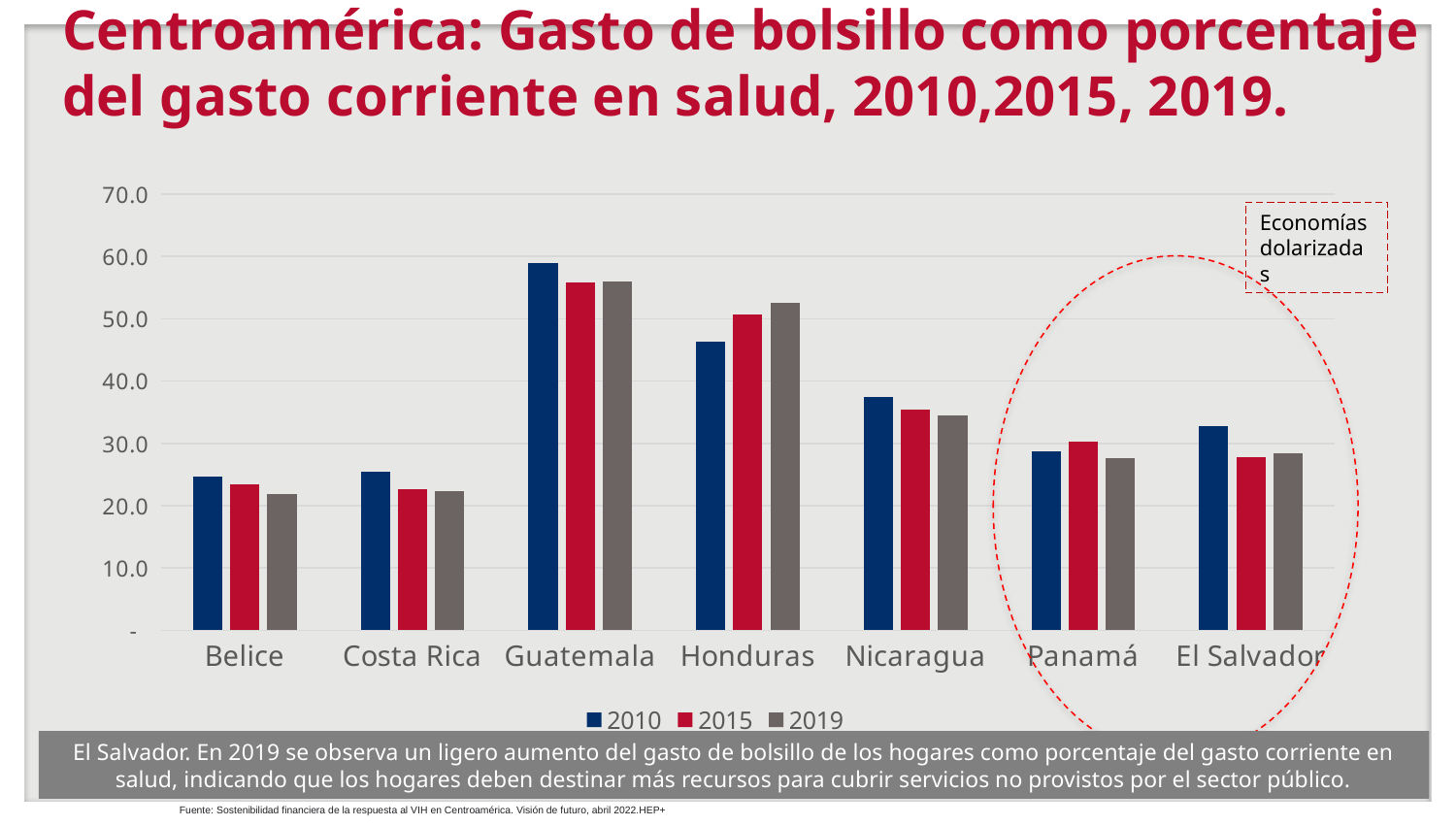
Which is larger, the 2010 value for Guatemala or the 2010 value for Honduras? Guatemala Is the 2010 value for Nicaragua greater or less than 40.0? less How many countries are shown on the x axis of the chart? 7 Do the values for Honduras rise or fall from 2010 to 2019? rise Is the 2019 value for Belice greater or less than 30.0? less What kind of chart is shown on the slide? bar chart Is the 2010 value for Guatemala greater or less than 50.0? greater Which two countries are enclosed by the dashed circle labelled 'Economías dolarizadas'? Panamá and El Salvador Which is larger, the 2019 value for Honduras or the 2019 value for Nicaragua? Honduras Which country has the highest value for 2019? Guatemala How many series does the legend list? 3 Which country has the highest value for 2010? Guatemala